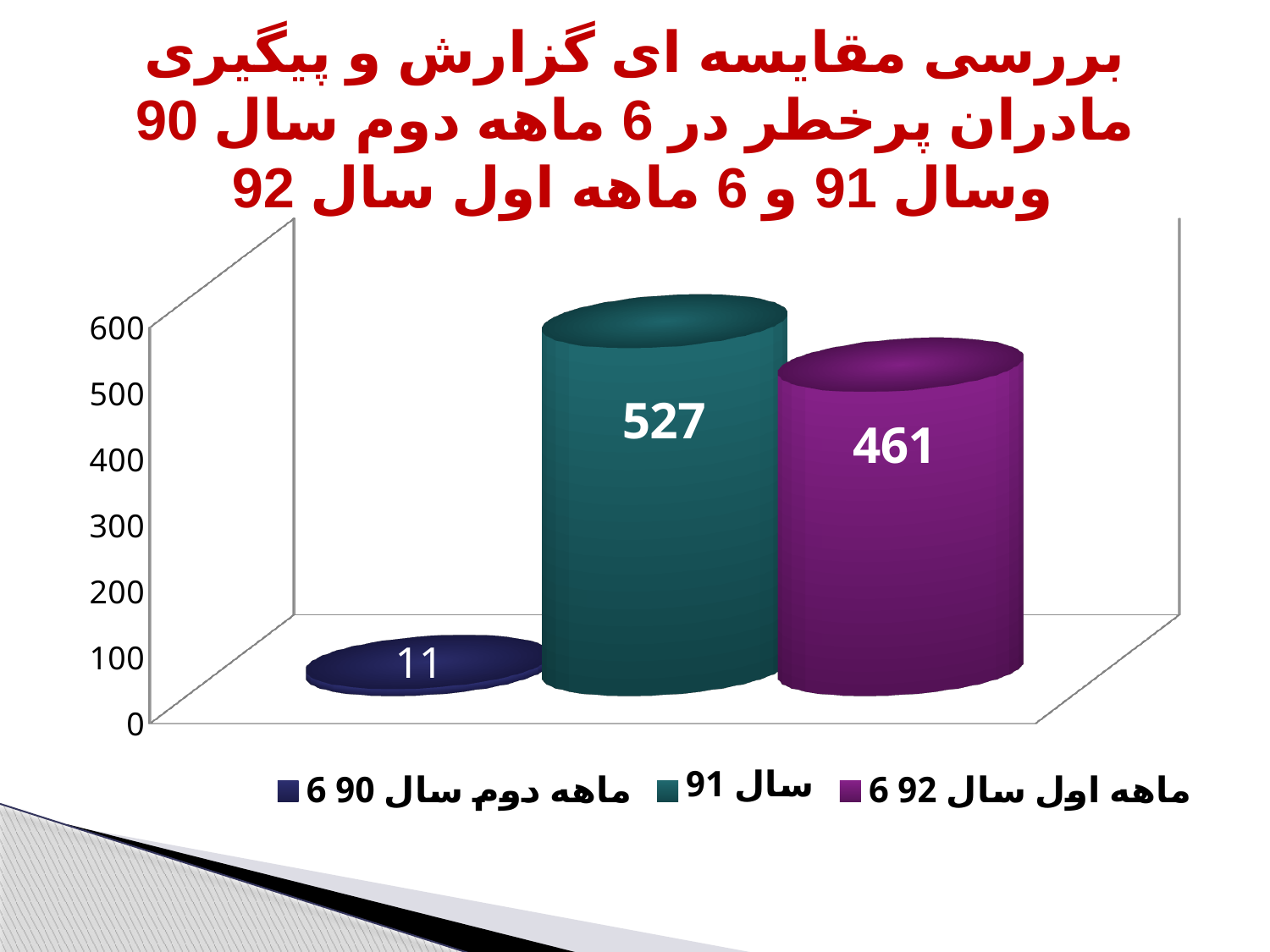
Is the value for 6 ماهه اول سال 92 greater or less than 400? greater What is the difference between the values for 6 ماهه اول سال 92 and 6 ماهه دوم سال 90? 450 What value is shown for 6 ماهه اول سال 92? 461 Which series has the lowest value? 6 ماهه دوم سال 90 Which series has the highest value? سال 91 What kind of chart is shown on the slide? bar chart Which is larger, the value for سال 91 or the value for 6 ماهه اول سال 92? سال 91 How many series does the legend list? 3 What value is shown for سال 91? 527 What colour is the bar for سال 91? teal What is the difference between the values for سال 91 and 6 ماهه اول سال 92? 66 What value is shown for 6 ماهه دوم سال 90? 11